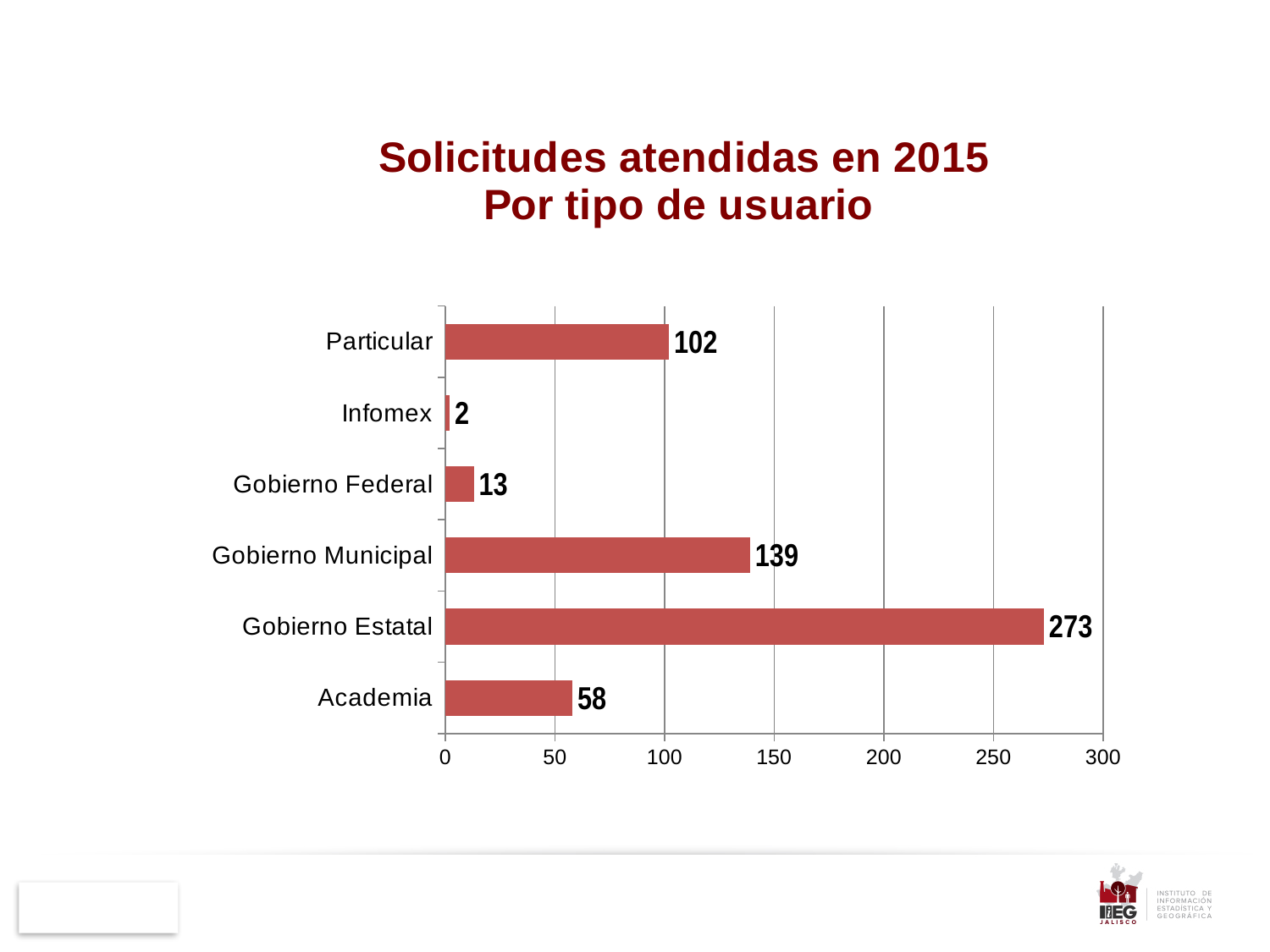
Which category has the highest value? Gobierno Estatal What is the difference between the values for Particular and Academia? 44 How many categories are shown in the chart? 6 Is the value for Gobierno Municipal greater or less than 100? greater Which category has the lowest value? Infomex What is the title of the chart? Solicitudes atendidas en 2015 Por tipo de usuario What is the value for Particular? 102 What is the value for Academia? 58 Which is larger, the value for Gobierno Federal or the value for Academia? Academia What is the value for Gobierno Estatal? 273 What is the difference between the values for Gobierno Estatal and Gobierno Municipal? 134 What kind of chart is shown on the slide? Bar chart